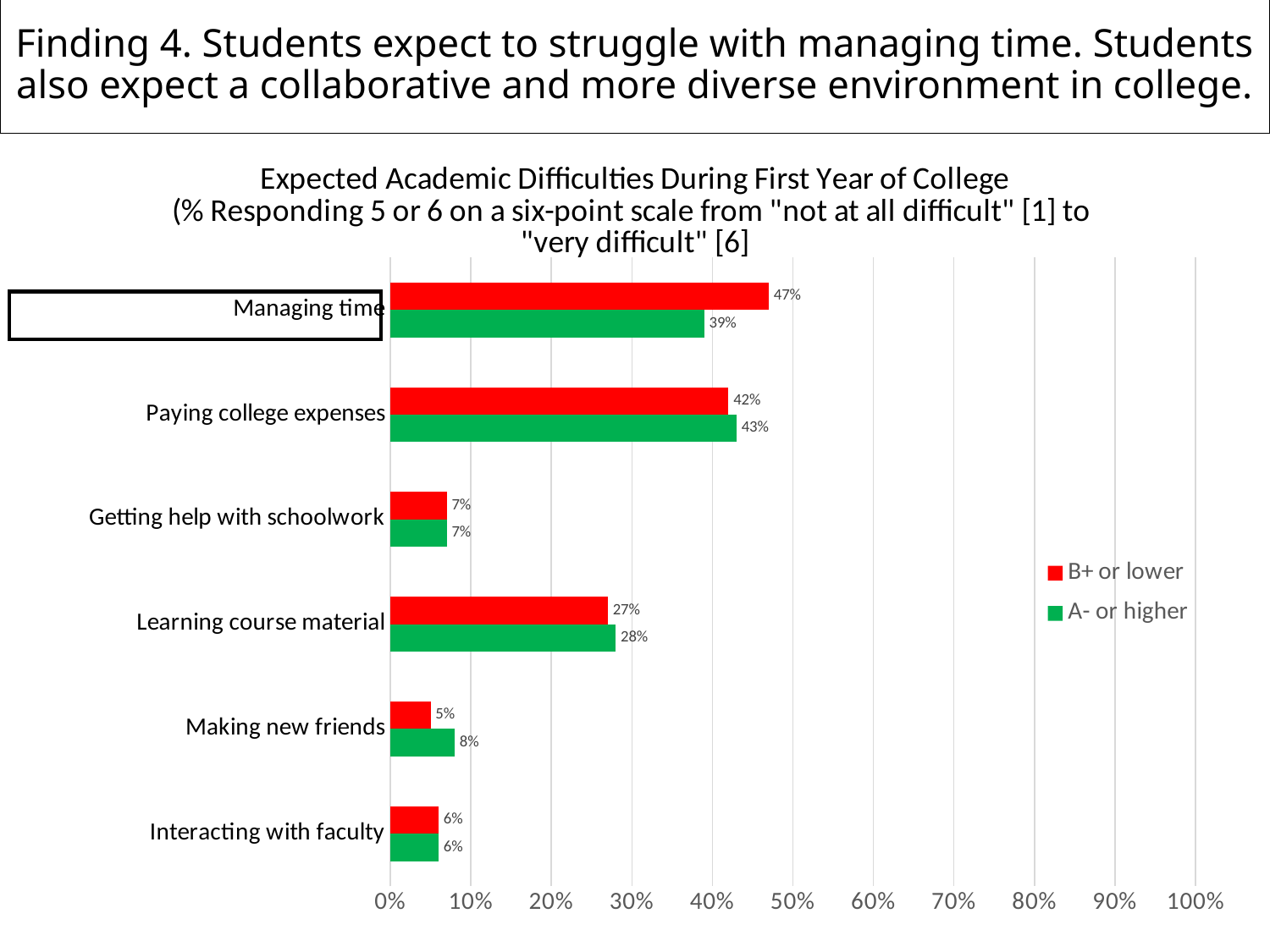
What is the value for "A- or higher" for Paying college expenses? 43% For Making new friends, which series has the larger value, "B+ or lower" or "A- or higher"? A- or higher What is the value for "A- or higher" for Making new friends? 8% What is the value for "B+ or lower" for Managing time? 47% Which category has the highest value for "B+ or lower"? Managing time Which category has the lowest value for "B+ or lower"? Making new friends How many series does the legend list? 2 Which colour represents the "A- or higher" series? Green Is the "A- or higher" value for Learning course material greater or less than 20%? greater What is the difference between the "B+ or lower" and "A- or higher" values for Managing time? 8% How many categories are shown on the chart? 6 What kind of chart is shown on the slide? Bar chart